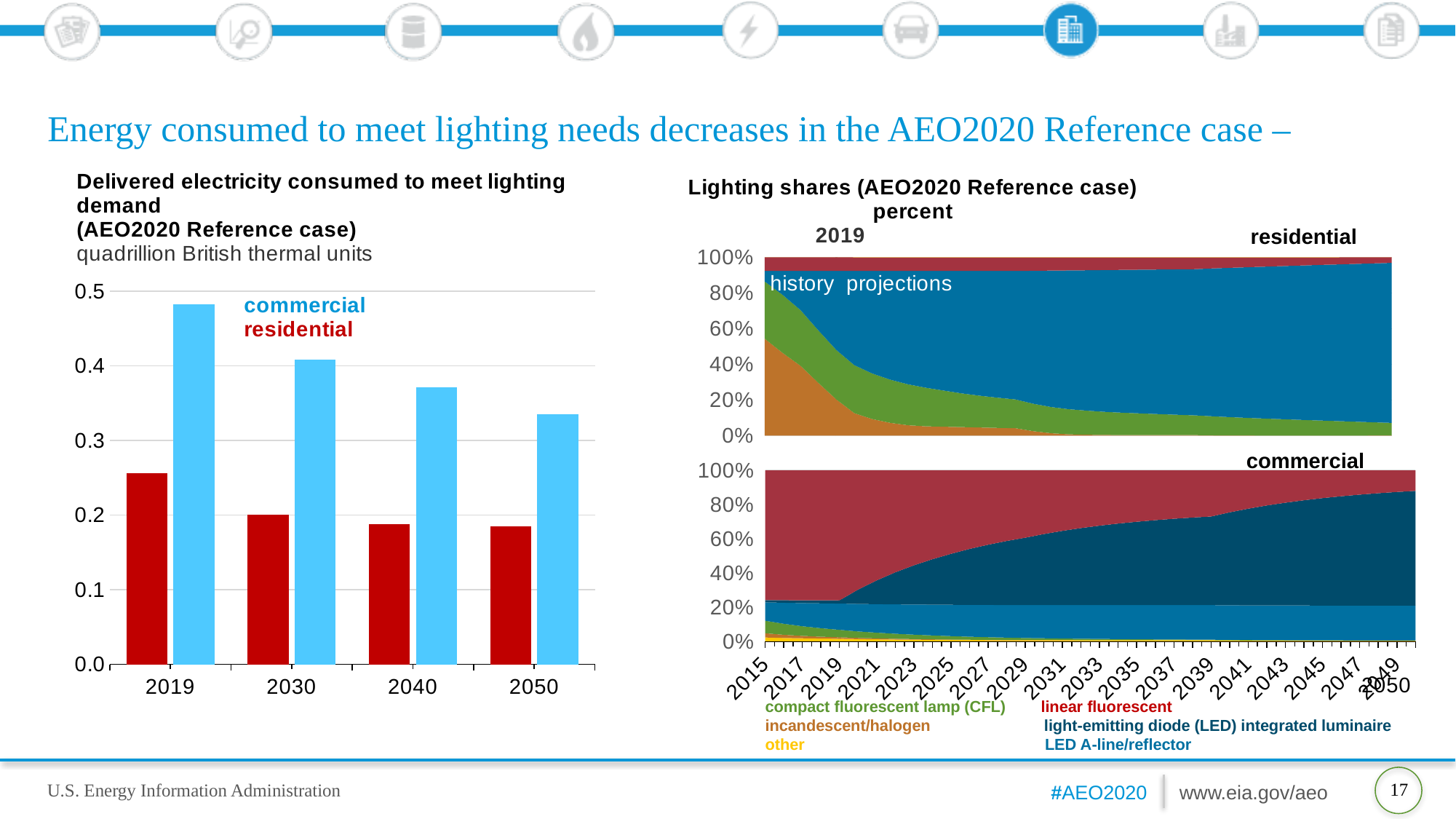
In the left bar chart, is the commercial value for 2050 greater or less than 0.4? less In the left bar chart, which year has the lowest commercial value? 2050 In the left bar chart, which is larger in 2019, commercial or residential? commercial What kind of chart is the 'Delivered electricity consumed to meet lighting demand' chart on the left? bar chart In the left bar chart, do the commercial values rise or fall from 2019 to 2050? fall In the left bar chart, which year has the highest commercial value? 2019 In the left bar chart, how many series are shown? 2 In the left bar chart, is the commercial value for 2019 greater or less than 0.4? greater In the left bar chart, how many years are shown on the x axis? 4 In the commercial 'Lighting shares' chart, does the share of light-emitting diode (LED) integrated luminaire rise or fall from 2019 to 2050? rise In the 'Lighting shares' charts on the right, how many lighting types does the legend list? 6 In the left bar chart, is the residential value for 2019 greater or less than 0.2? greater